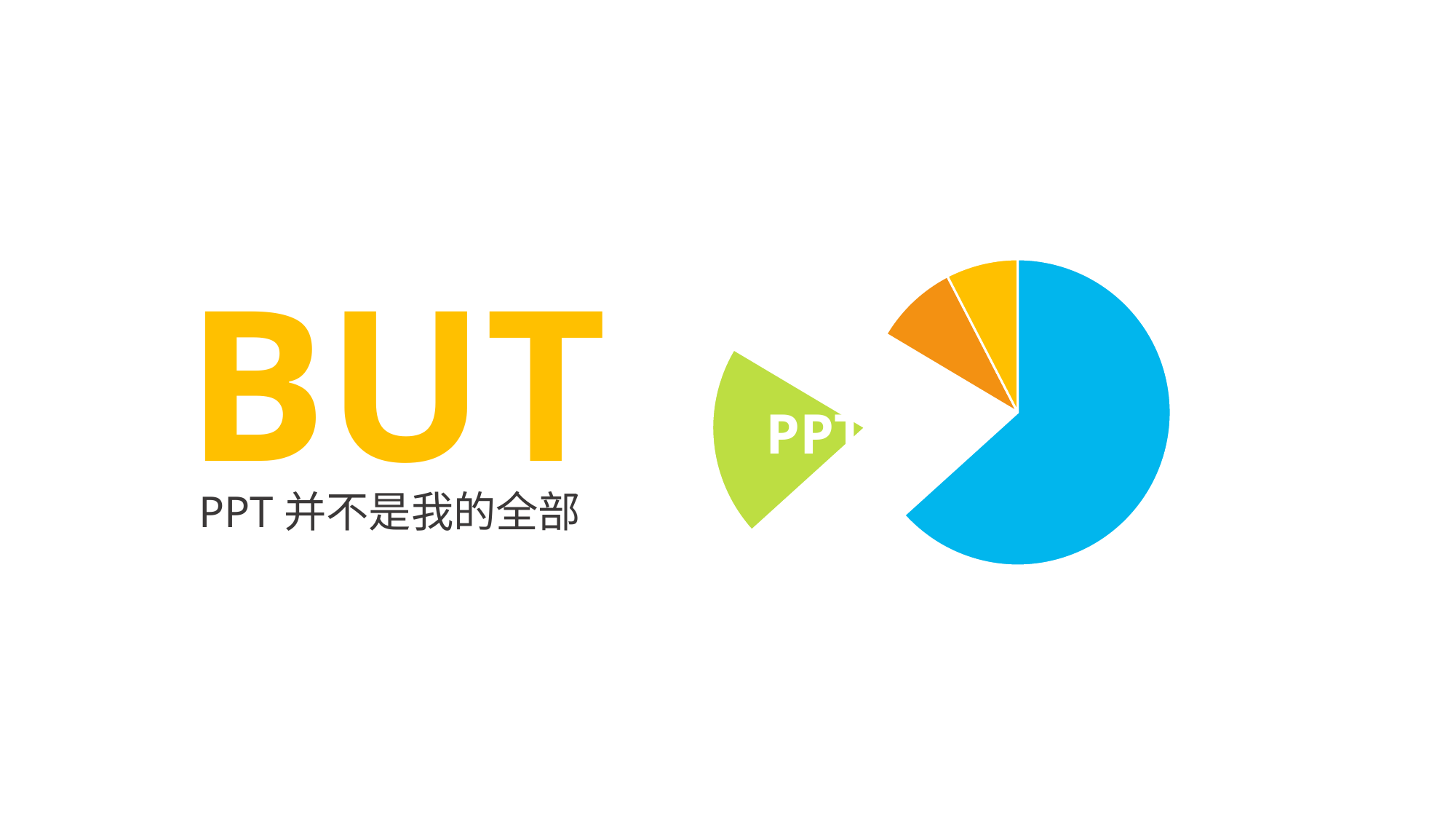
What label is printed on the green slice of the pie chart? PPT What kind of chart is shown on the slide? pie chart What colour is the largest slice of the pie chart? blue Which slice of the pie chart is pulled out (exploded) from the rest? the green PPT slice Is the PPT slice larger or smaller than the blue slice? smaller How many slices does the pie chart have? 4 Does the PPT slice make up more or less than half of the pie? less